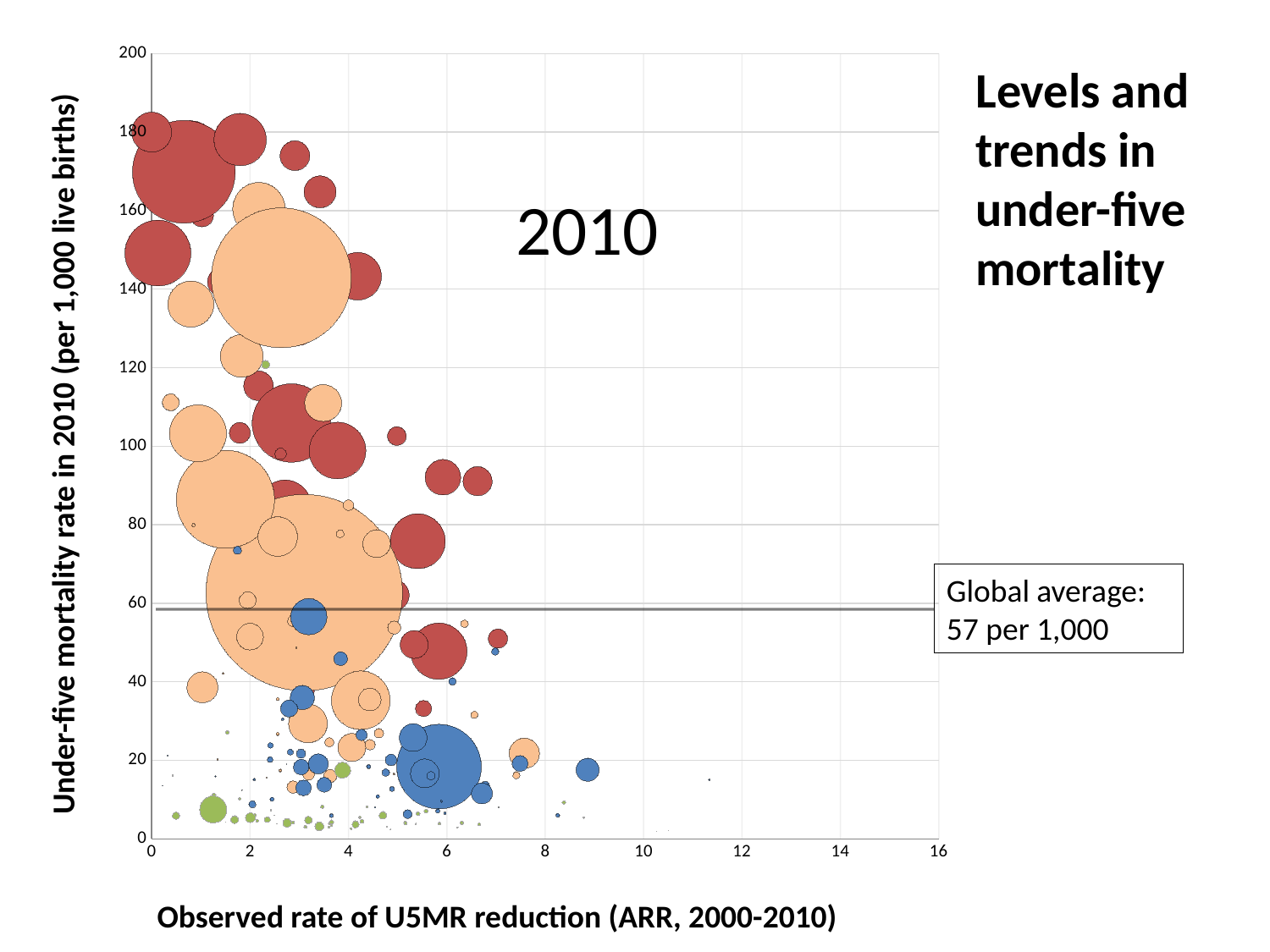
Is the global average under-five mortality rate marked on the chart greater or less than 40? greater What year is shown as the chart's title? 2010 What is the label of the x axis of the chart? Observed rate of U5MR reduction (ARR, 2000-2010) What kind of chart is shown on the slide? bubble chart Is the global average under-five mortality rate marked on the chart greater or less than 60? less What is the global average under-five mortality rate shown on the chart? 57 per 1,000